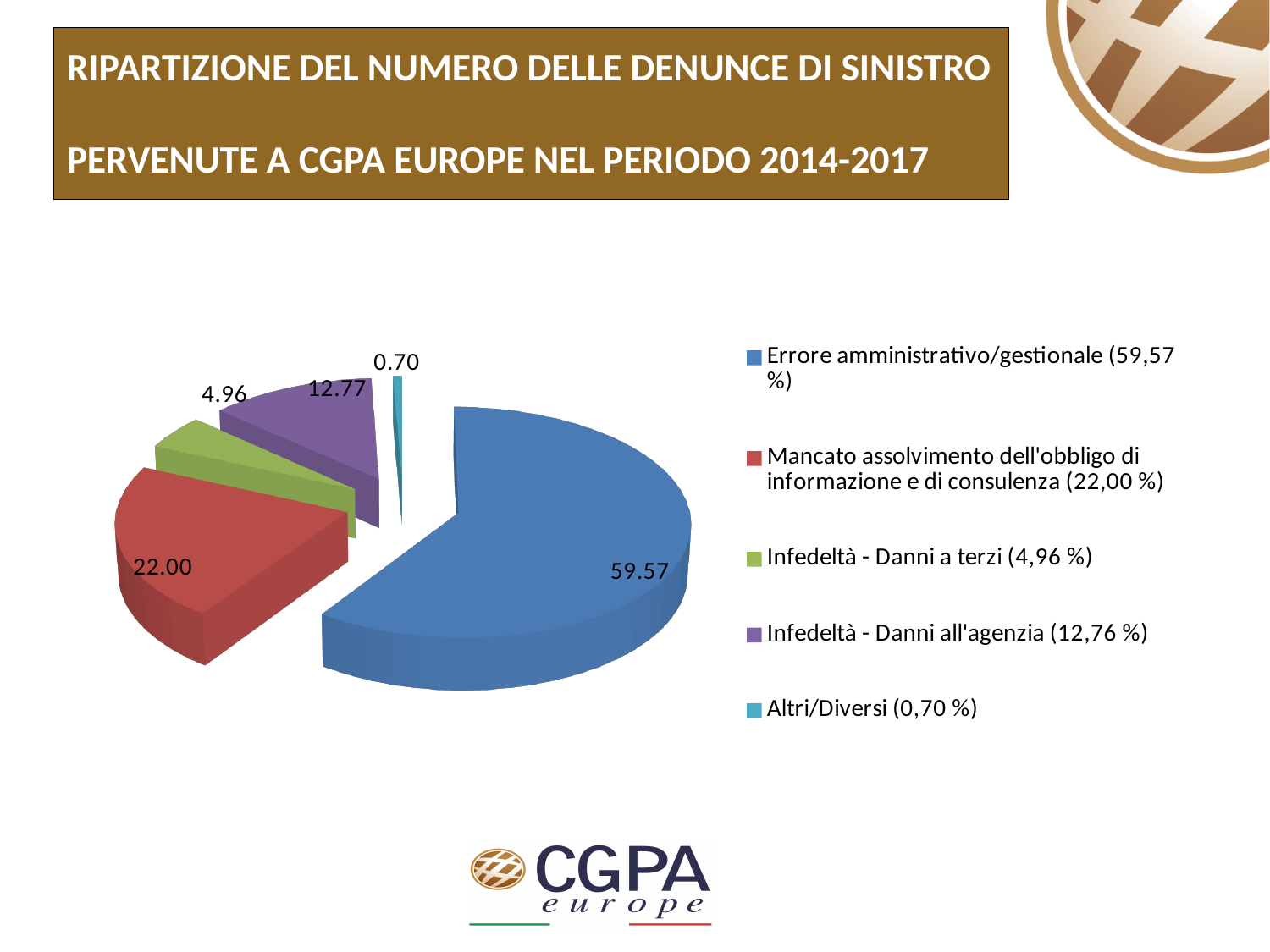
What colour is the Mancato assolvimento dell'obbligo di informazione e di consulenza slice? red What is the data label value for the Infedeltà - Danni a terzi slice? 4.96 What percentage does the legend give for Altri/Diversi? 0,70 % Which category has the largest slice of the pie? Errore amministrativo/gestionale Which slice is larger: Infedeltà - Danni a terzi or Infedeltà - Danni all'agenzia? Infedeltà - Danni all'agenzia What is the data label value for the Altri/Diversi slice? 0.70 Which category has the smallest slice of the pie? Altri/Diversi What is the data label value for the Mancato assolvimento dell'obbligo di informazione e di consulenza slice? 22.00 What kind of chart is shown on the slide? pie chart How many slices does the pie chart have? 5 What is the data label value for the Errore amministrativo/gestionale slice? 59.57 What is the difference between the data labels for Errore amministrativo/gestionale and Mancato assolvimento dell'obbligo di informazione e di consulenza? 37.57